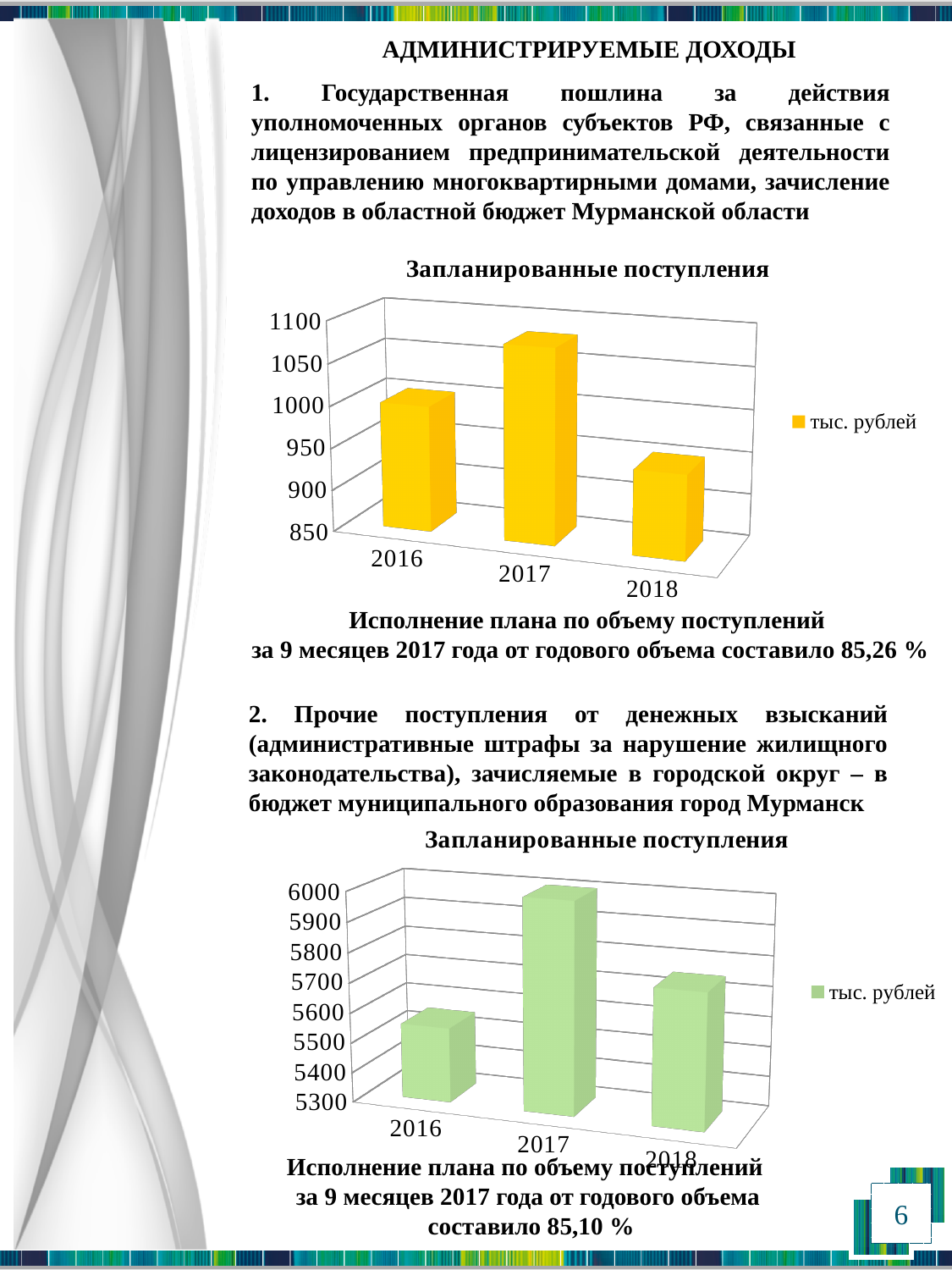
In the bottom chart, which year has the lowest planned revenue? 2016 In the top chart, is the value for 2017 greater or less than 1050? greater What kind of chart is the top chart titled "Запланированные поступления"? bar chart In the bottom chart, which year has the highest planned revenue? 2017 In the top chart, which year has the highest planned revenue? 2017 In the bottom chart, how many series does the legend list? 1 In the top chart, which year has the lowest planned revenue? 2018 In the top chart, how many years are shown on the x axis? 3 In the bottom chart, is the value for 2017 greater or less than 5800? greater In the bottom chart, is the value for 2016 greater or less than 5700? less In the top chart, what is the legend entry? тыс. рублей